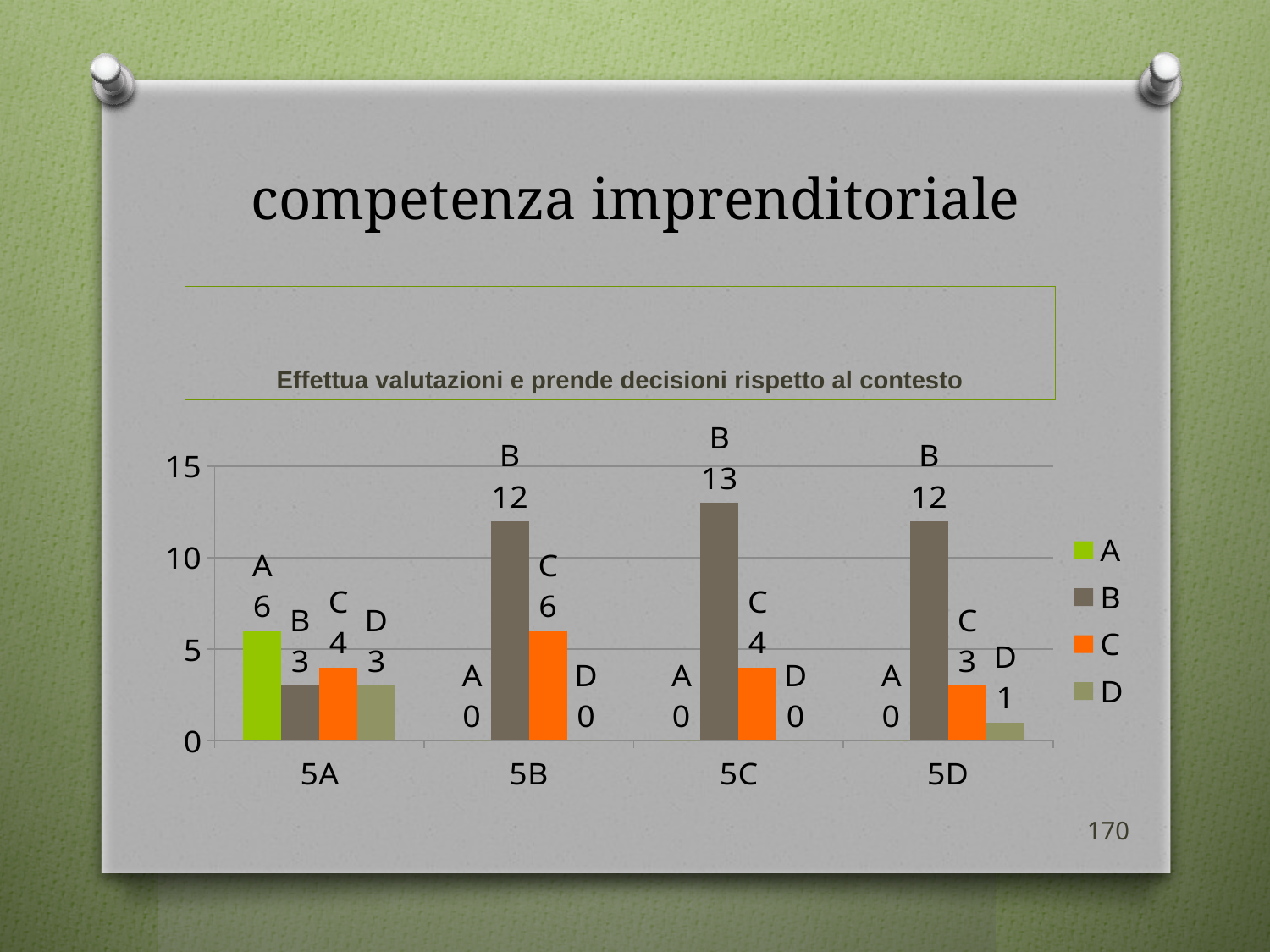
Which category has the lowest value for series B? 5A How many series does the legend list? 4 What kind of chart is shown on the slide? bar chart What is the value of series B for category 5C? 13 How many categories are shown on the x axis? 4 Which is larger: series C for 5A or series C for 5B? series C for 5B What is the title of the slide? competenza imprenditoriale What is the difference between series B and series C for category 5D? 9 What is the value of series D for category 5D? 1 What is the value of series A for category 5A? 6 What is the value of series C for category 5B? 6 Which category has the highest value for series B? 5C